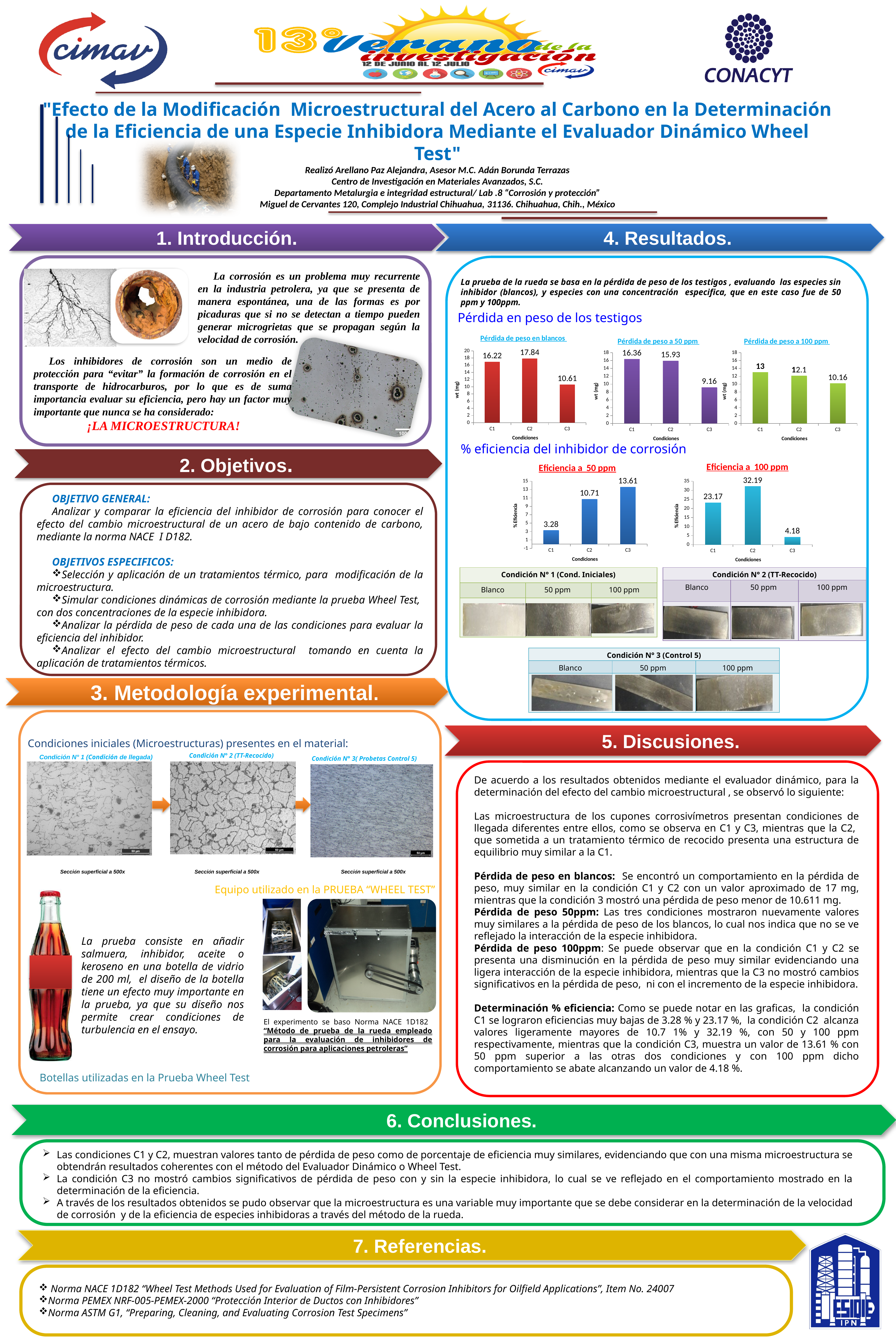
In the "Pérdida de peso en blancos" chart, which condition has the lowest value? C3 In the "Eficiencia a 50 ppm" chart, do the values rise or fall from C1 to C3? rise What kind of chart is the "Pérdida de peso en blancos" chart? bar chart In the "Eficiencia a 100 ppm" chart, what is the value for C2? 32.19 In the "Pérdida de peso en blancos" chart, what is the value for C2? 17.84 In the "Eficiencia a 50 ppm" chart, what is the value for C1? 3.28 In the "Pérdida de peso a 50 ppm" chart, what is the difference between the values for C1 and C2? 0.43 In the "Eficiencia a 100 ppm" chart, what is the difference between the values for C2 and C1? 9.02 In the "Pérdida de peso a 100 ppm" chart, what is the value for C1? 13 In the "Eficiencia a 100 ppm" chart, which is larger, the value for C1 or the value for C3? C1 In the "Pérdida de peso a 50 ppm" chart, what is the value for C3? 9.16 In the "Pérdida de peso a 100 ppm" chart, which condition has the highest value? C1